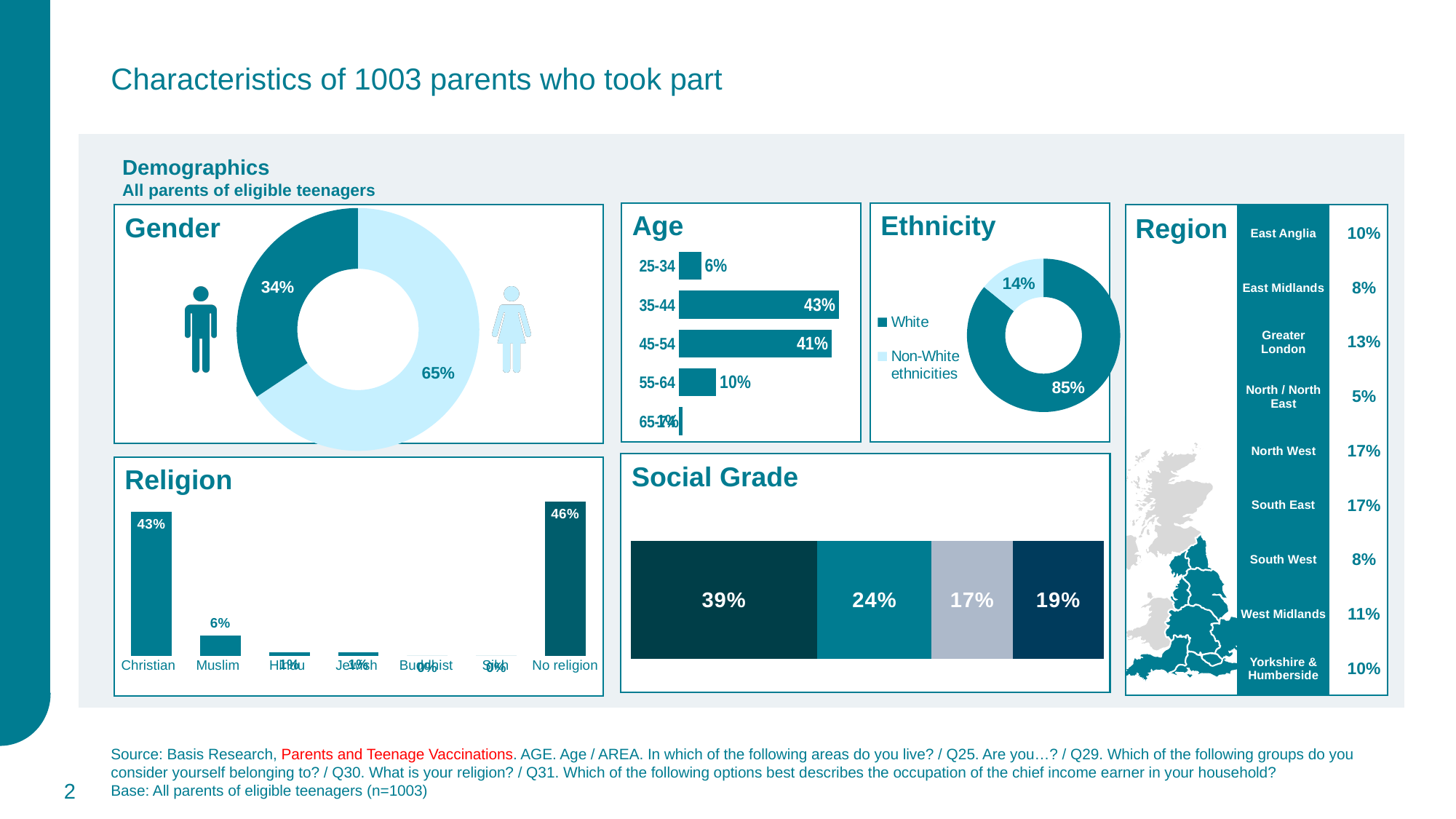
What kind of chart is the Gender chart? Donut chart In the Age chart, which age group has the highest value? 35-44 In the Social Grade chart, what is the value of the largest (leftmost) segment? 39% In the Gender chart, what percentage of parents are male (the darker slice)? 34% How many series does the legend of the Ethnicity chart list? 2 In the Ethnicity chart, what percentage of parents are White? 85% In the Age chart, which is larger, the value for 25-34 or the value for 55-64? 55-64 In the Age chart, what is the difference between the 45-54 and 55-64 age groups? 31% In the Religion chart, which category has the highest value? No religion In the Gender chart, what percentage of parents are female (the lighter slice)? 65% In the Religion chart, what is the difference between No religion and Christian? 3% In the Age chart, what is the value for the 35-44 age group? 43%